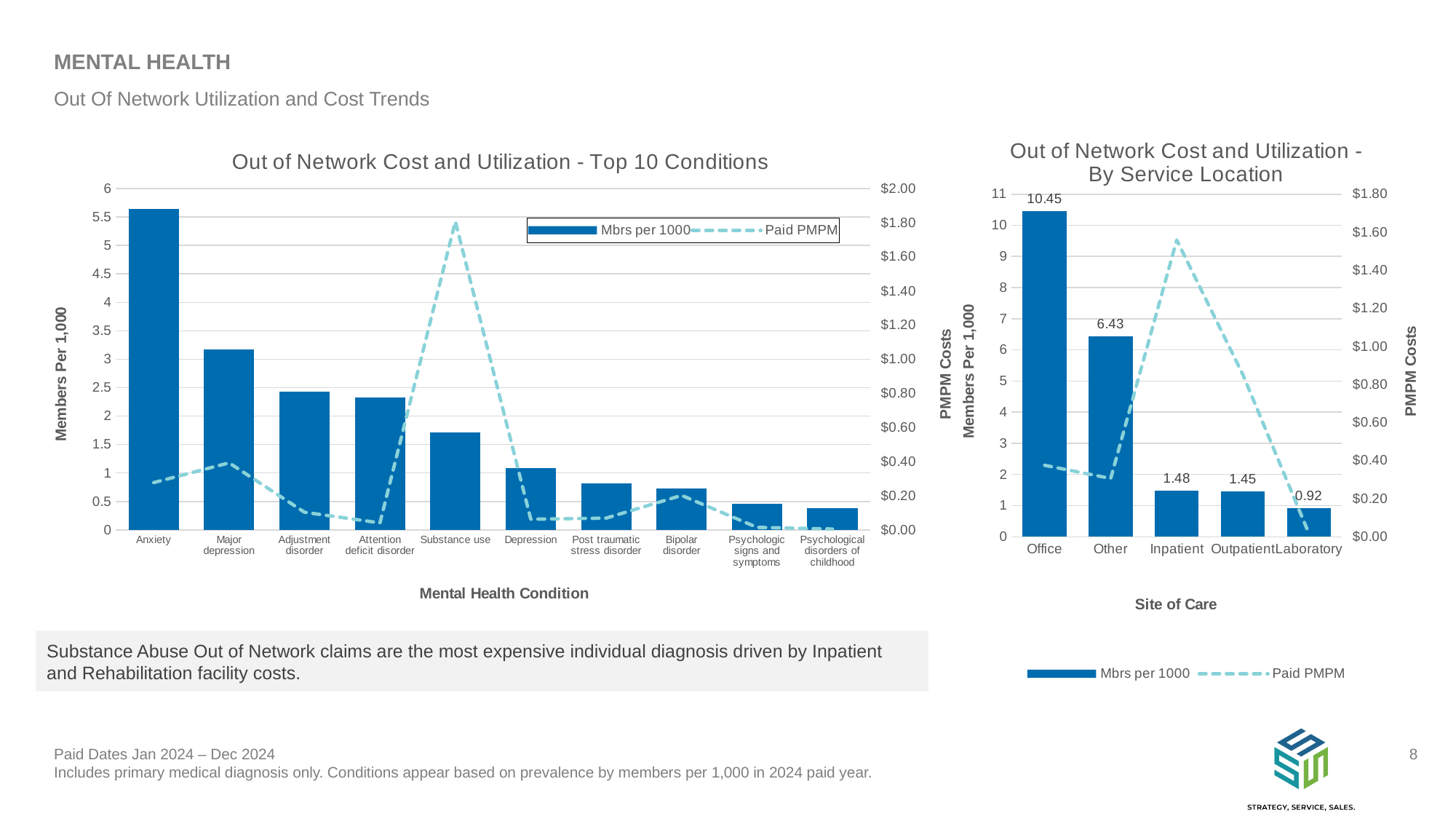
In the 'Top 10 Conditions' chart, is the Mbrs per 1000 value for Anxiety greater or less than 5? greater In the 'Top 10 Conditions' chart, which condition has the highest Paid PMPM? Substance use In the 'Top 10 Conditions' chart, which condition has the highest Mbrs per 1000? Anxiety How many series does the legend of the 'Top 10 Conditions' chart list? 2 In the 'Top 10 Conditions' chart, do the Mbrs per 1000 bars rise or fall from left to right along the x axis? fall In the 'By Service Location' chart, what is the difference in Mbrs per 1000 between Office and Other? 4.02 In the 'By Service Location' chart, what is the Mbrs per 1000 value for Other? 6.43 In the 'By Service Location' chart, which site of care has the highest Paid PMPM? Inpatient In the 'By Service Location' chart, which site of care has the lowest Mbrs per 1000? Laboratory In the 'By Service Location' chart, what is the Mbrs per 1000 value for Laboratory? 0.92 In the 'By Service Location' chart, how many sites of care are shown on the x axis? 5 In the 'By Service Location' chart, what is the Mbrs per 1000 value for Office? 10.45